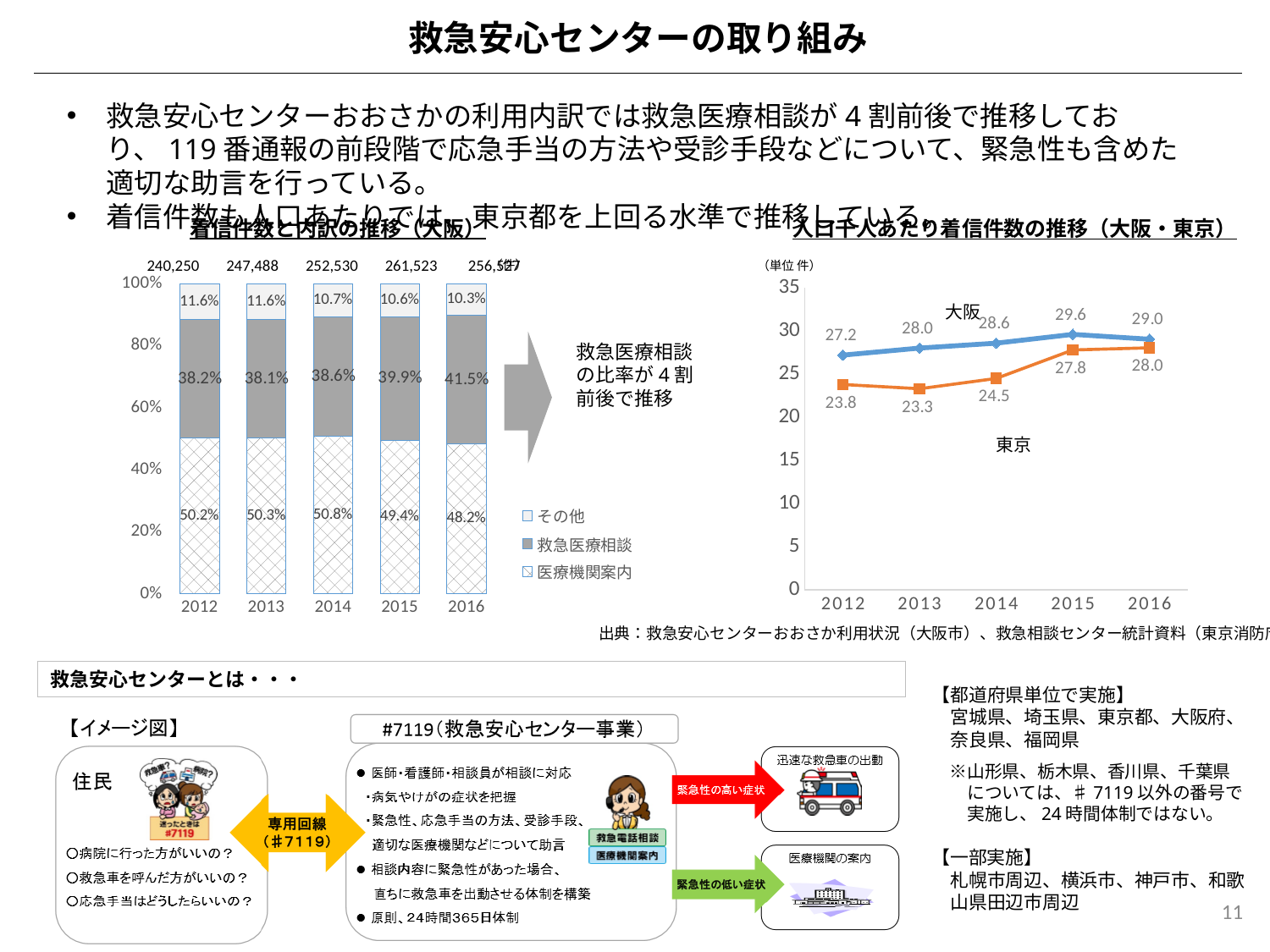
In the chart titled 着信件数と内訳の推移（大阪）, what is the total number of calls shown above the 2015 bar? 261,523 In the chart titled 着信件数と内訳の推移（大阪）, what is the value for 医療機関案内 in 2014? 50.8% In the chart titled 人口千人あたり着信件数の推移（大阪・東京）, which year has the lowest value for 東京? 2013 In the chart titled 着信件数と内訳の推移（大阪）, what is the value for 救急医療相談 in 2016? 41.5% In the chart titled 着信件数と内訳の推移（大阪）, what is the value for その他 in 2012? 11.6% In the chart titled 着信件数と内訳の推移（大阪）, what is the difference between the 医療機関案内 share in 2012 and in 2016? 2.0% In the chart titled 人口千人あたり着信件数の推移（大阪・東京）, what is the value for 大阪 in 2015? 29.6 What kind of chart is 人口千人あたり着信件数の推移（大阪・東京）? line chart In the chart titled 人口千人あたり着信件数の推移（大阪・東京）, what is the difference between 大阪 and 東京 in 2012? 3.4 In the chart titled 着信件数と内訳の推移（大阪）, in which year is the 救急医療相談 share highest? 2016 In the chart titled 着信件数と内訳の推移（大阪）, how many series does the legend list? 3 In the chart titled 人口千人あたり着信件数の推移（大阪・東京）, what is the value for 東京 in 2013? 23.3